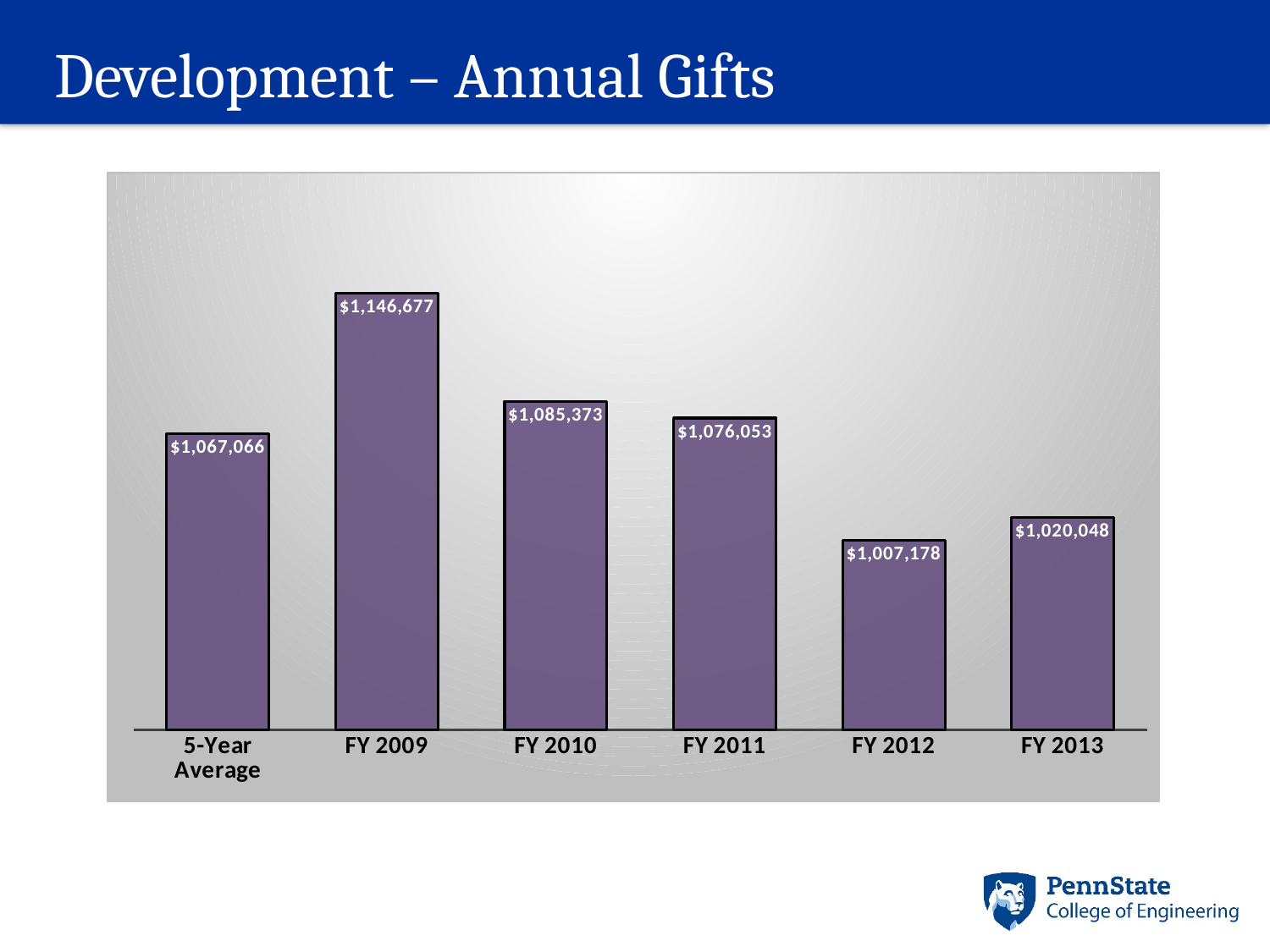
How many bars are shown in the chart? 6 What is the value for FY 2009? $1,146,677 Which category has the lowest value? FY 2012 What kind of chart is shown on the slide? Bar chart From FY 2009 to FY 2012, do the values rise or fall? Fall What is the value for the 5-Year Average bar? $1,067,066 What is the value for FY 2012? $1,007,178 Which is larger, the value for FY 2010 or the value for FY 2013? FY 2010 Which category has the highest value? FY 2009 What is the value for FY 2013? $1,020,048 What is the difference between the FY 2009 and FY 2012 values? $139,499 What is the difference between the FY 2013 and FY 2012 values? $12,870